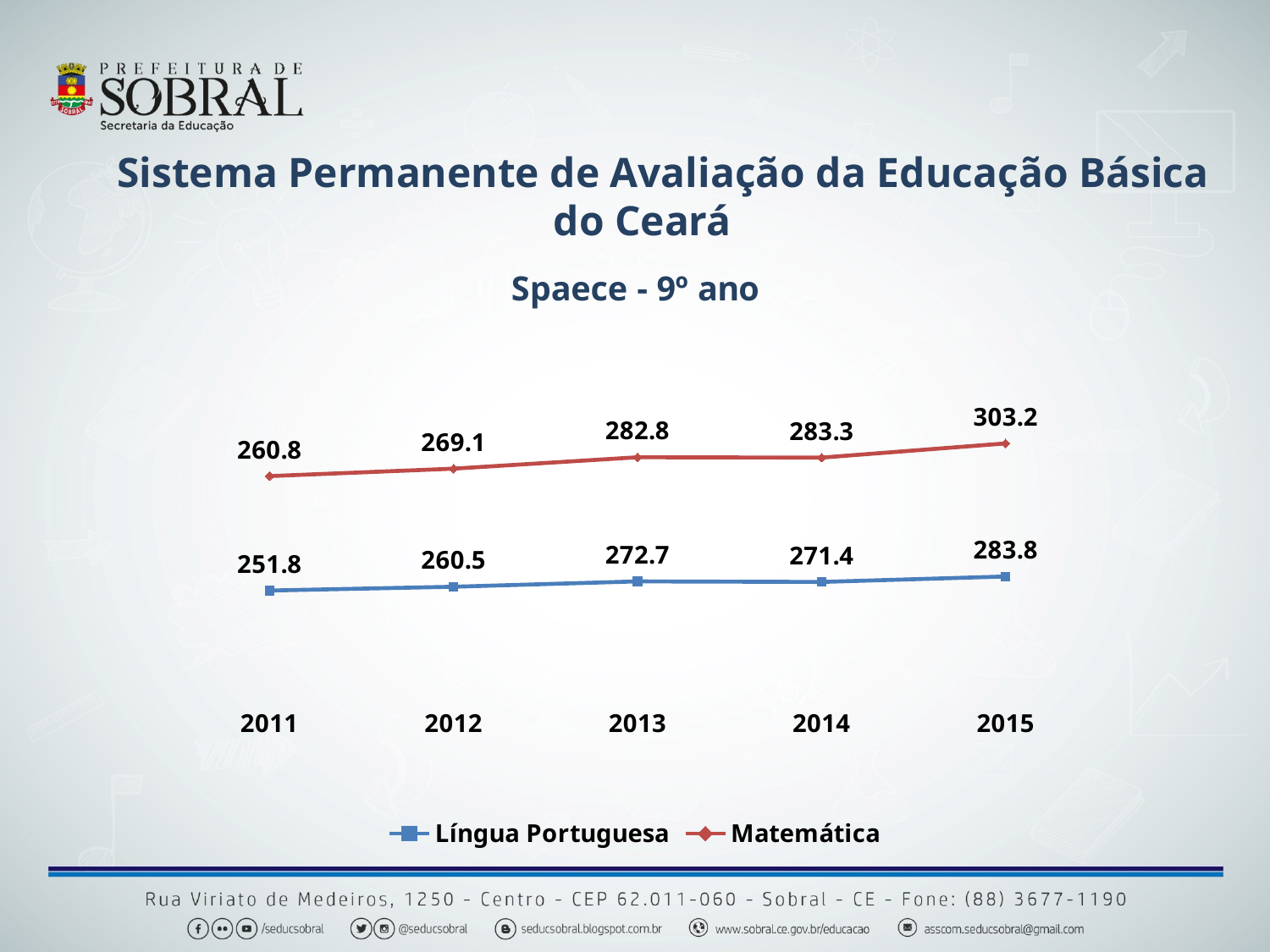
Which is larger, the Matemática value for 2014 or the Matemática value for 2013? 2014 What is the Língua Portuguesa value for 2013? 272.7 Does the Matemática series generally rise or fall from 2011 to 2015? rise How many years are plotted on the x axis? 5 What is the Língua Portuguesa value for 2011? 251.8 What kind of chart is shown on the slide? line chart In which year is the Língua Portuguesa value lowest? 2011 What is the difference between the Língua Portuguesa values for 2012 and 2011? 8.7 What is the Matemática value for 2015? 303.2 How many series does the legend list? 2 What is the difference between the Matemática and Língua Portuguesa values in 2015? 19.4 In which year is the Matemática value highest? 2015